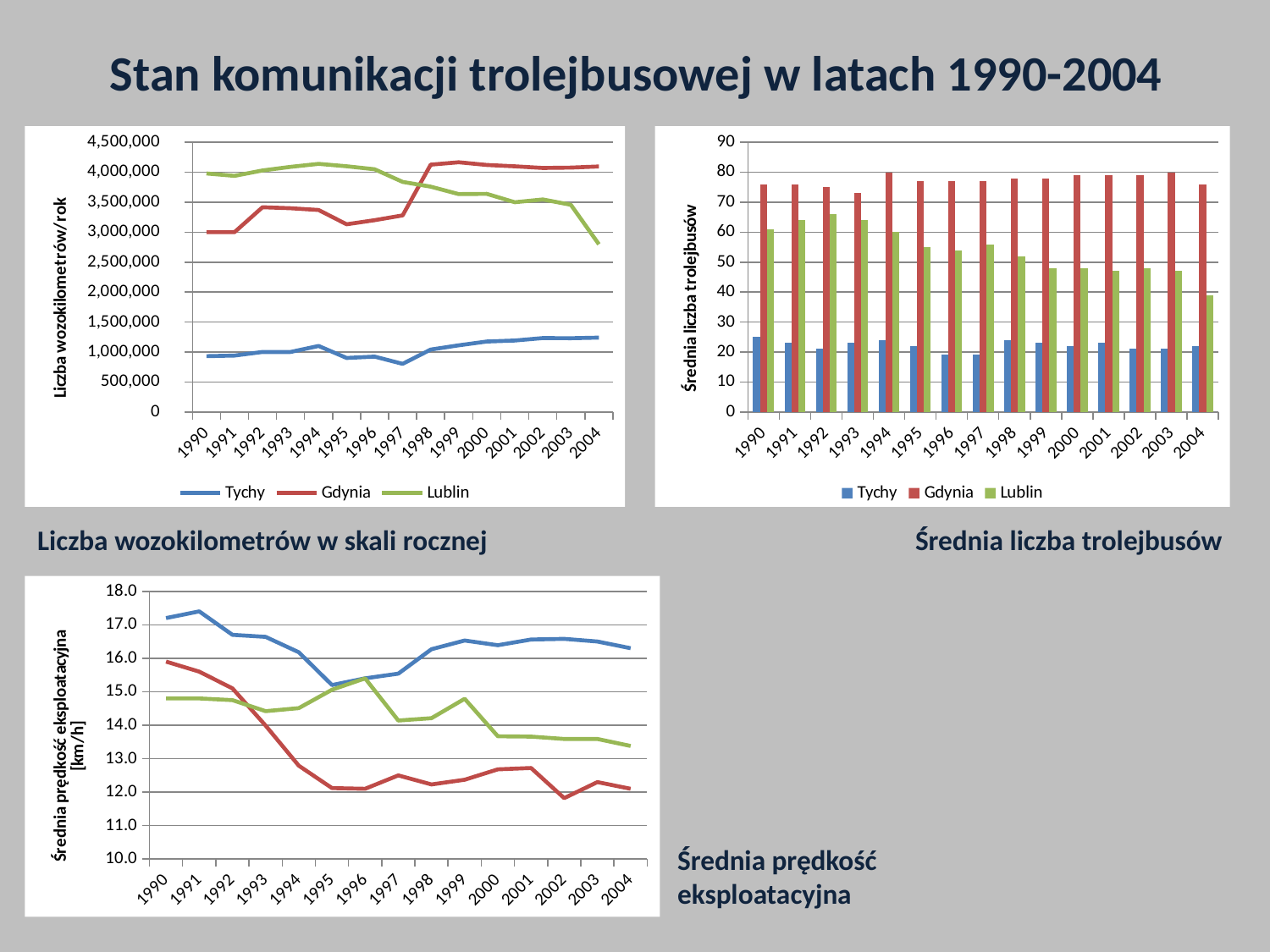
In the top-left chart 'Liczba wozokilometrów w skali rocznej', how many series does the legend list? 3 In the top-right chart 'Średnia liczba trolejbusów', how many years are shown on the x axis? 15 What kind of chart is the top-left chart titled 'Liczba wozokilometrów w skali rocznej'? line chart In the top-left chart 'Liczba wozokilometrów w skali rocznej', is the value for Gdynia in 1999 greater or less than 4,000,000? greater In the bottom-left chart 'Średnia prędkość eksploatacyjna', what is the label of the y axis? Średnia prędkość eksploatacyjna [km/h] In the top-right chart 'Średnia liczba trolejbusów', is the value for Gdynia in 1994 greater or less than 70? greater In the top-right chart 'Średnia liczba trolejbusów', which city has the highest value in every year? Gdynia In the top-right chart 'Średnia liczba trolejbusów', does the value for Lublin generally rise or fall from 1990 to 2004? fall In the top-left chart 'Liczba wozokilometrów w skali rocznej', which series has the larger value in 2004, Gdynia or Lublin? Gdynia In the top-left chart 'Liczba wozokilometrów w skali rocznej', is the value for Tychy in 2004 greater or less than 1,500,000? less What kind of chart is the top-right chart titled 'Średnia liczba trolejbusów'? bar chart